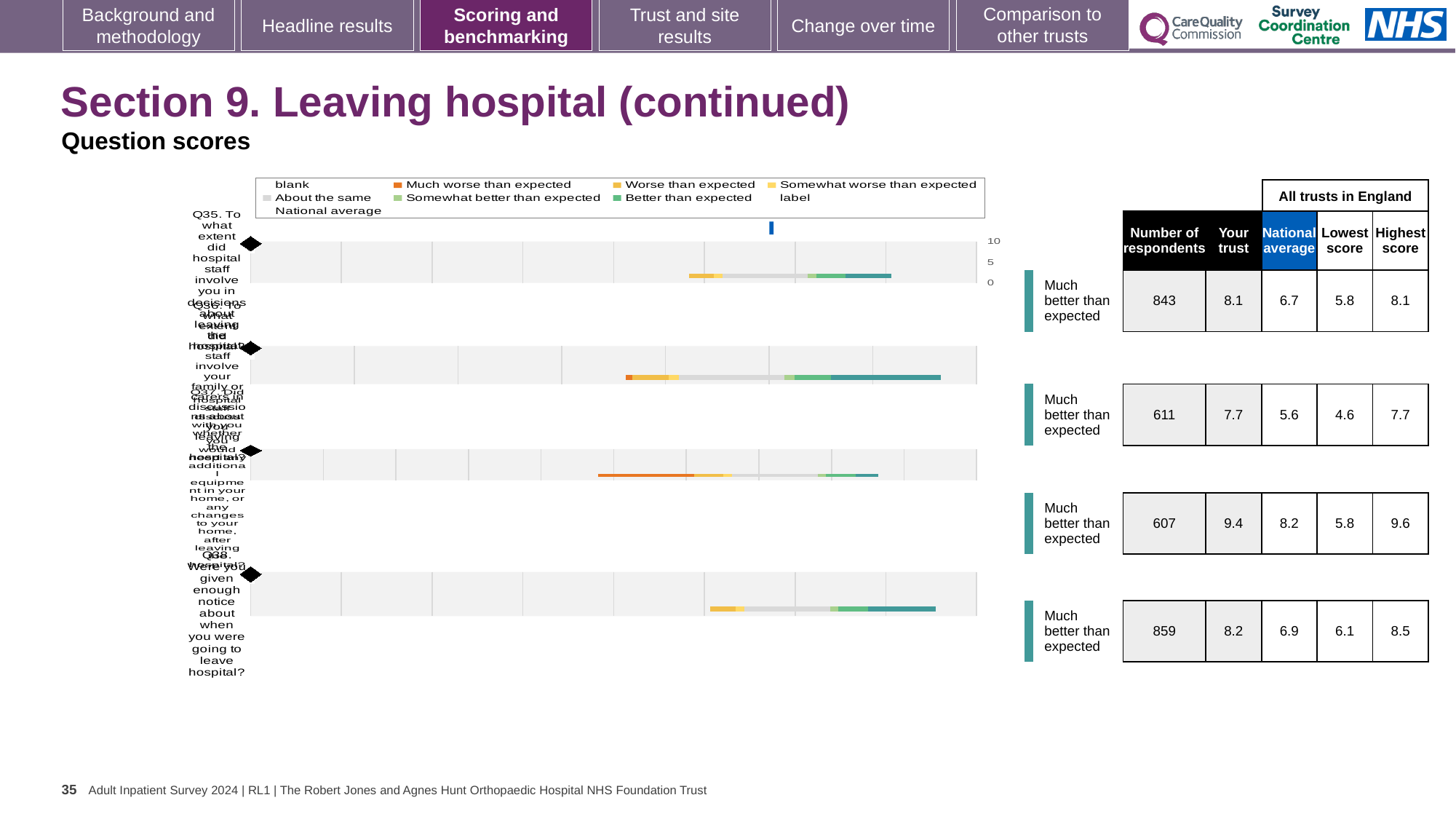
What colour represents 'Much worse than expected' in the chart legend? orange What is the highest score across all trusts in England for the third row of the chart? 9.6 What type of chart is used to show the question scores on this slide? bar chart How many questions (rows) are plotted in the chart? 4 What is the national average score for Q35 (the first row of the chart)? 6.7 For Q38 (the last row), which is larger: the 'Your trust' score or the national average? Your trust How many respondents are listed for Q38 (the last row of the chart)? 859 What is the difference between the 'Your trust' score and the national average for Q35 (the first row)? 1.4 What benchmark category is shown for every question row on this slide? Much better than expected Which row of the chart has the highest 'Your trust' score? the third row (9.4) What is the 'Your trust' score for Q35 (the first row of the chart)? 8.1 Which row of the chart has the lowest 'Lowest score' value? the second row (4.6)